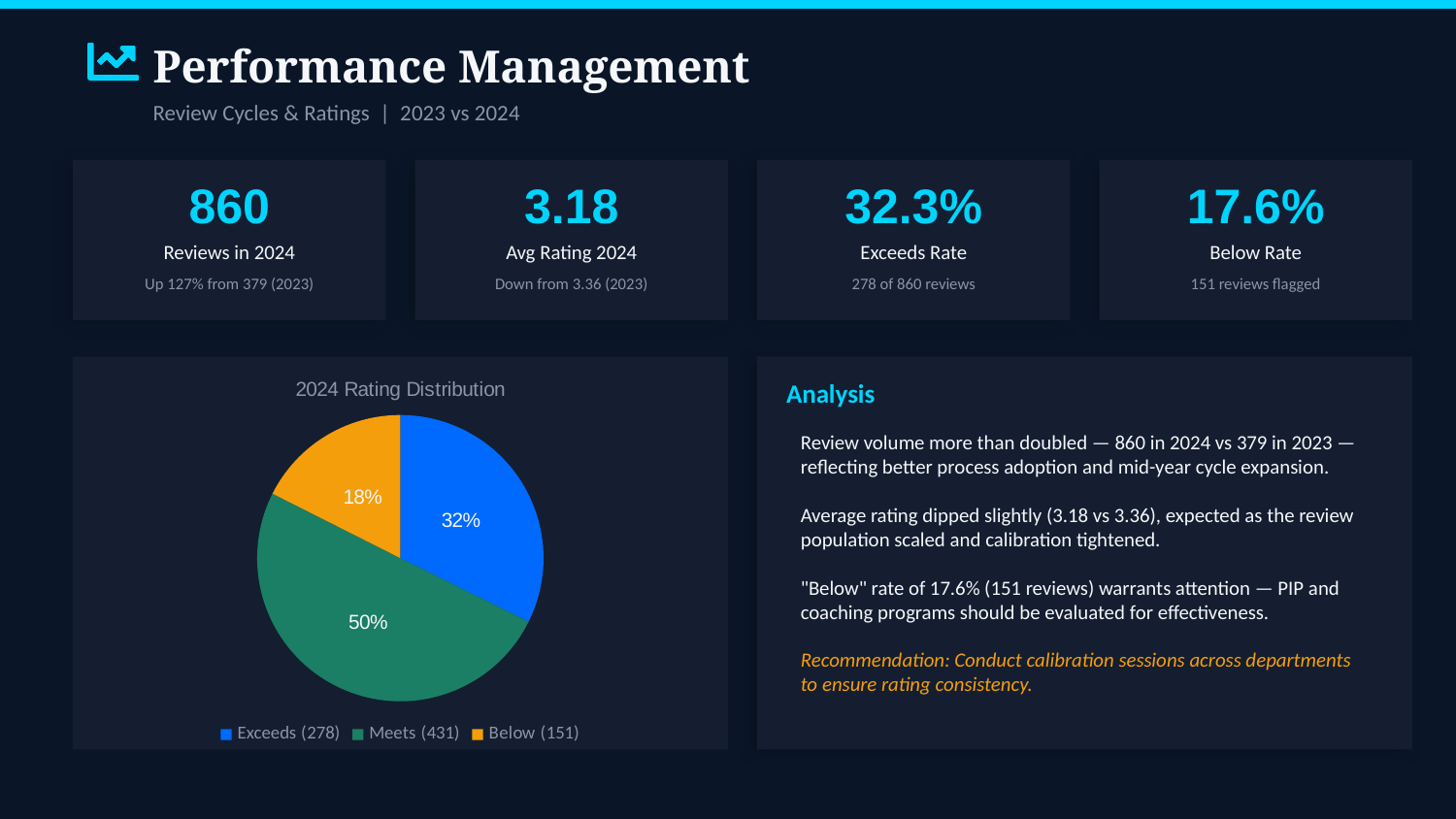
What share of the pie does the Meets slice represent? 50% How many entries does the chart legend list? 3 Which rating category has the smallest slice of the pie? Below What colour is the Below slice in the pie chart? orange What is the title of the chart? 2024 Rating Distribution What share of the pie does the Below slice represent? 18% What is the difference in percentage points between the Meets slice and the Exceeds slice? 18% What kind of chart is shown on the slide? pie chart What share of the pie does the Exceeds slice represent? 32% How many slices does the pie chart have? 3 Which rating category has the largest slice of the pie? Meets Which slice is larger, Exceeds or Below? Exceeds